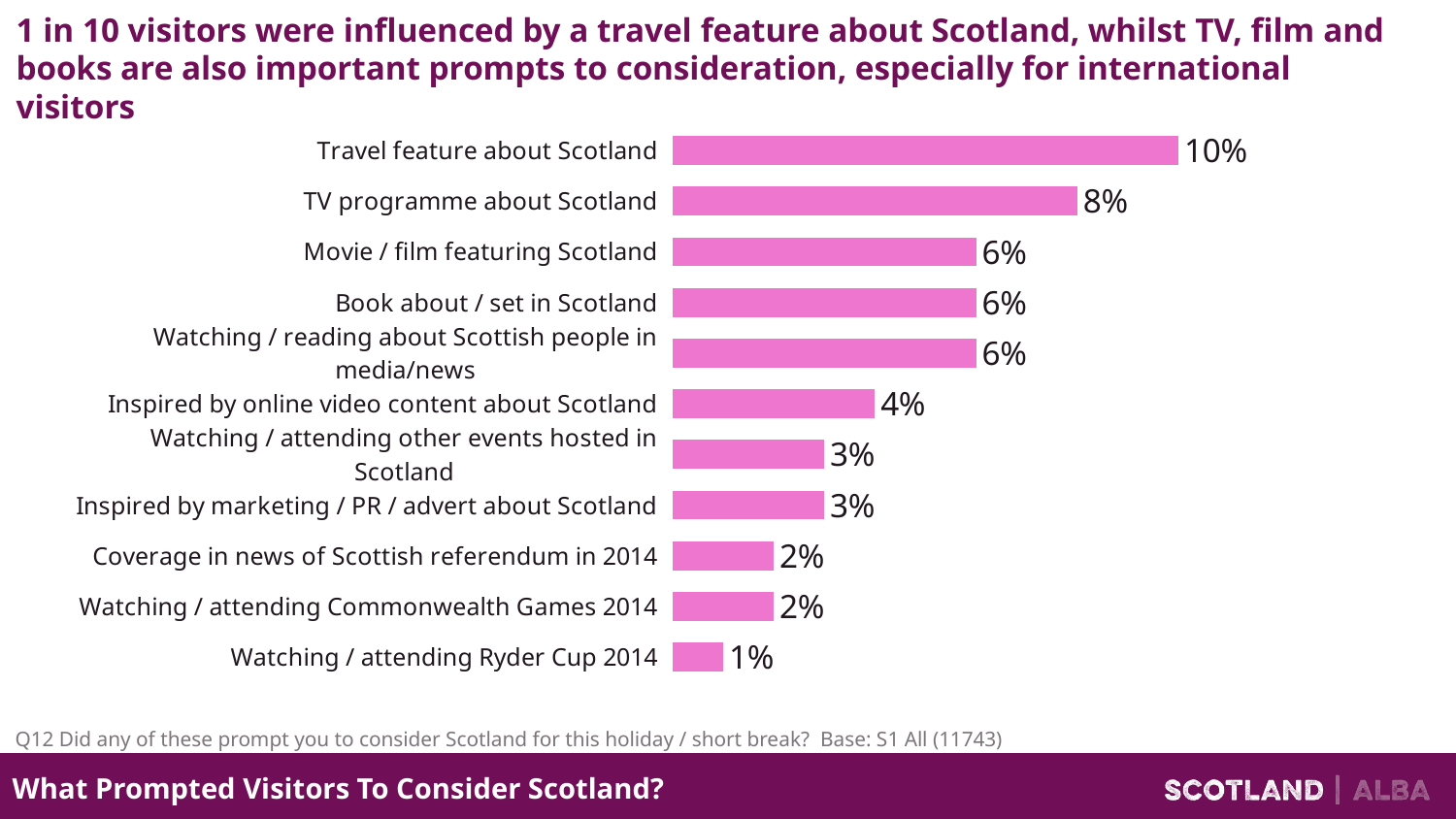
Which is larger: the value for 'TV programme about Scotland' or 'Book about / set in Scotland'? TV programme about Scotland What is the difference between the values for 'Movie / film featuring Scotland' and 'Inspired by marketing / PR / advert about Scotland'? 3% What colour are the bars in the chart? Pink How many categories are shown in the chart? 11 What is the value for 'Watching / attending Ryder Cup 2014'? 1% What is the value for 'TV programme about Scotland'? 8% What is the value for 'Inspired by online video content about Scotland'? 4% What type of chart is shown on the slide? Bar chart Which category has the lowest value? Watching / attending Ryder Cup 2014 What is the difference between the values for 'Travel feature about Scotland' and 'TV programme about Scotland'? 2% What percentage of visitors were prompted by a travel feature about Scotland? 10% Which category has the highest value? Travel feature about Scotland